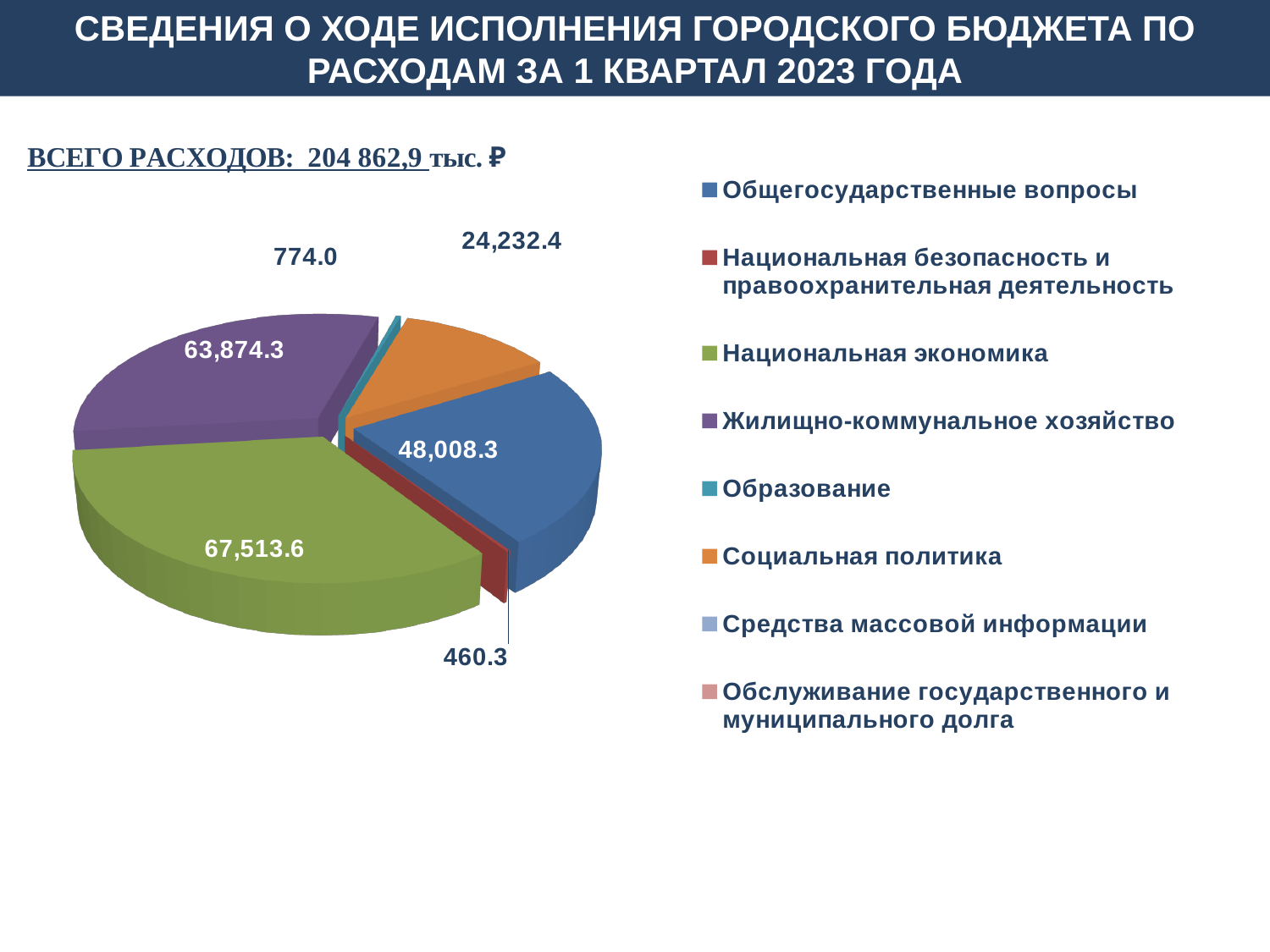
What is the value shown for Национальная безопасность и правоохранительная деятельность? 460.3 How many entries does the legend list? 8 What is the value shown for Общегосударственные вопросы? 48,008.3 What is the value shown for Жилищно-коммунальное хозяйство? 63,874.3 Which is larger, the value for Общегосударственные вопросы or the value for Социальная политика? Общегосударственные вопросы What is the value shown for Социальная политика? 24,232.4 What is the difference between the values for Национальная экономика and Жилищно-коммунальное хозяйство? 3,639.3 Which labelled category has the smallest value? Национальная безопасность и правоохранительная деятельность What is the value shown for Национальная экономика? 67,513.6 What type of chart is shown on the slide? Pie chart What is the value shown for Образование? 774.0 Which category has the largest slice of the pie? Национальная экономика